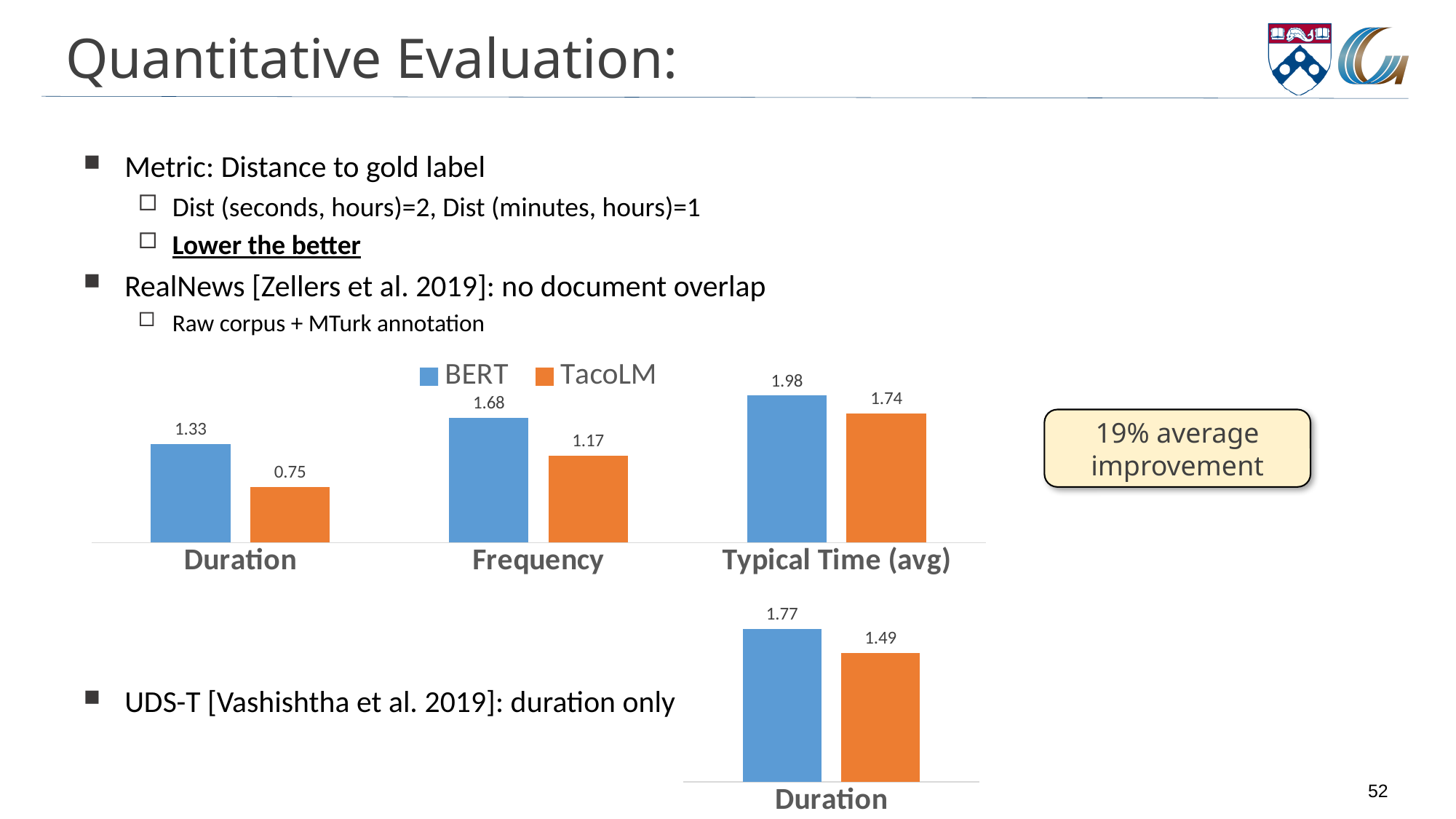
In the upper chart (RealNews), which category has the lowest TacoLM value? Duration How many categories are shown on the x axis of the upper chart (RealNews)? 3 In the lower chart (UDS-T), what is the TacoLM value for Duration? 1.49 In the upper chart (RealNews), what is the difference between the BERT and TacoLM values for Duration? 0.58 How many series does the legend of the upper chart (RealNews) list? 2 In the lower chart (UDS-T), what is the difference between the BERT and TacoLM values for Duration? 0.28 In the upper chart (RealNews), which is larger for Frequency, the BERT value or the TacoLM value? BERT In the upper chart (RealNews), what is the BERT value for Typical Time (avg)? 1.98 What kind of chart is the lower chart (UDS-T Duration)? Bar chart In the upper chart (RealNews), what is the BERT value for Duration? 1.33 In the upper chart (RealNews), what is the TacoLM value for Frequency? 1.17 In the upper chart (RealNews), which category has the highest BERT value? Typical Time (avg)